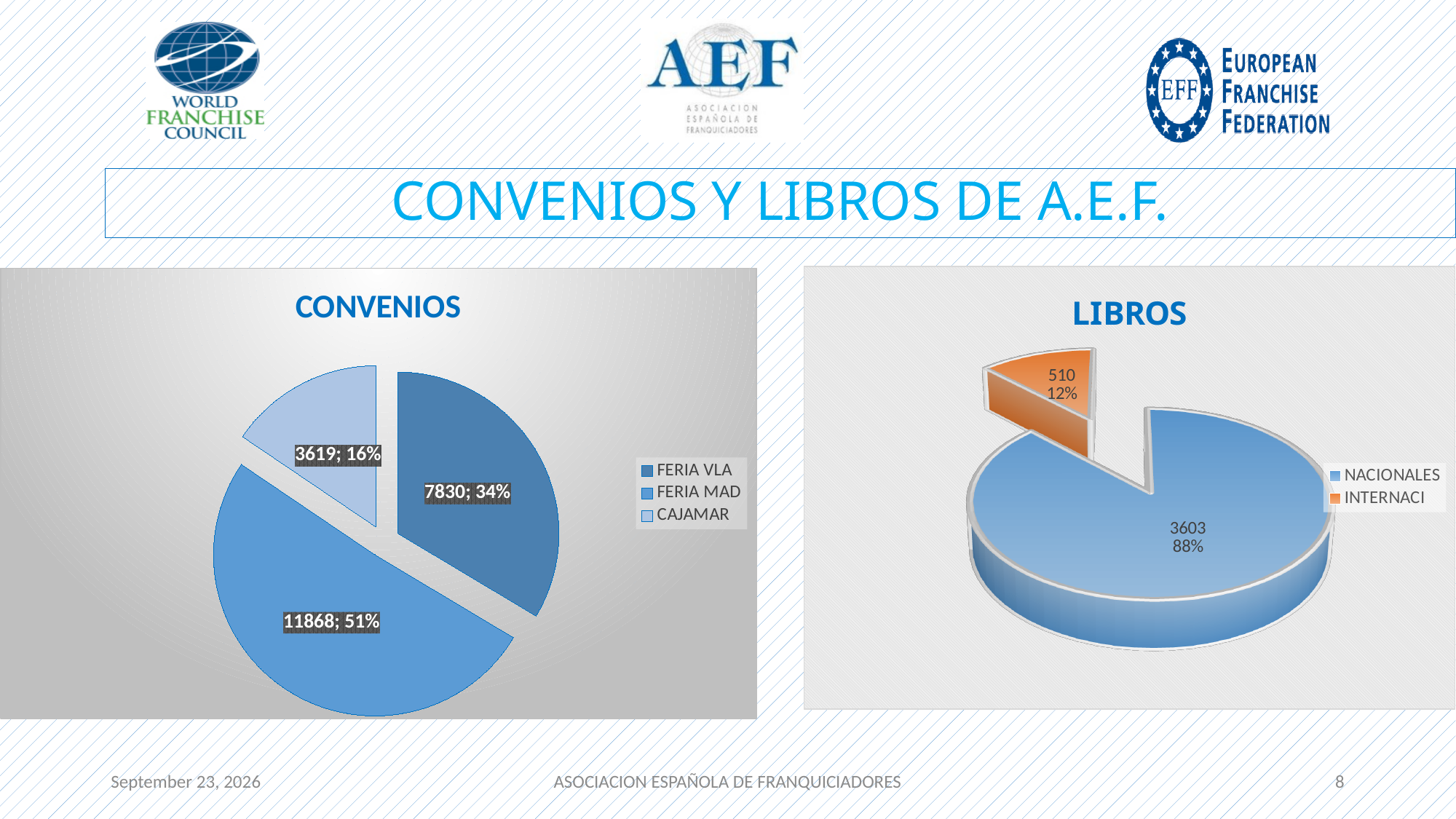
In the CONVENIOS chart, what is the difference between the FERIA MAD and FERIA VLA values? 4038 In the LIBROS chart, what is the difference between the NACIONALES and INTERNACI values? 3093 In the CONVENIOS chart, what value is shown for FERIA VLA? 7830 In the LIBROS chart, what value is shown for NACIONALES? 3603 In the CONVENIOS chart, which category has the largest slice? FERIA MAD In the LIBROS chart, which is larger, NACIONALES or INTERNACI? NACIONALES In the CONVENIOS chart, what percentage share does CAJAMAR have? 16% In the CONVENIOS chart, which category has the smallest slice? CAJAMAR In the LIBROS chart, what percentage share does INTERNACI have? 12% In the CONVENIOS chart, how many categories are shown? 3 In the CONVENIOS chart, what value is shown for FERIA MAD? 11868 What type of chart is the LIBROS chart? Pie chart